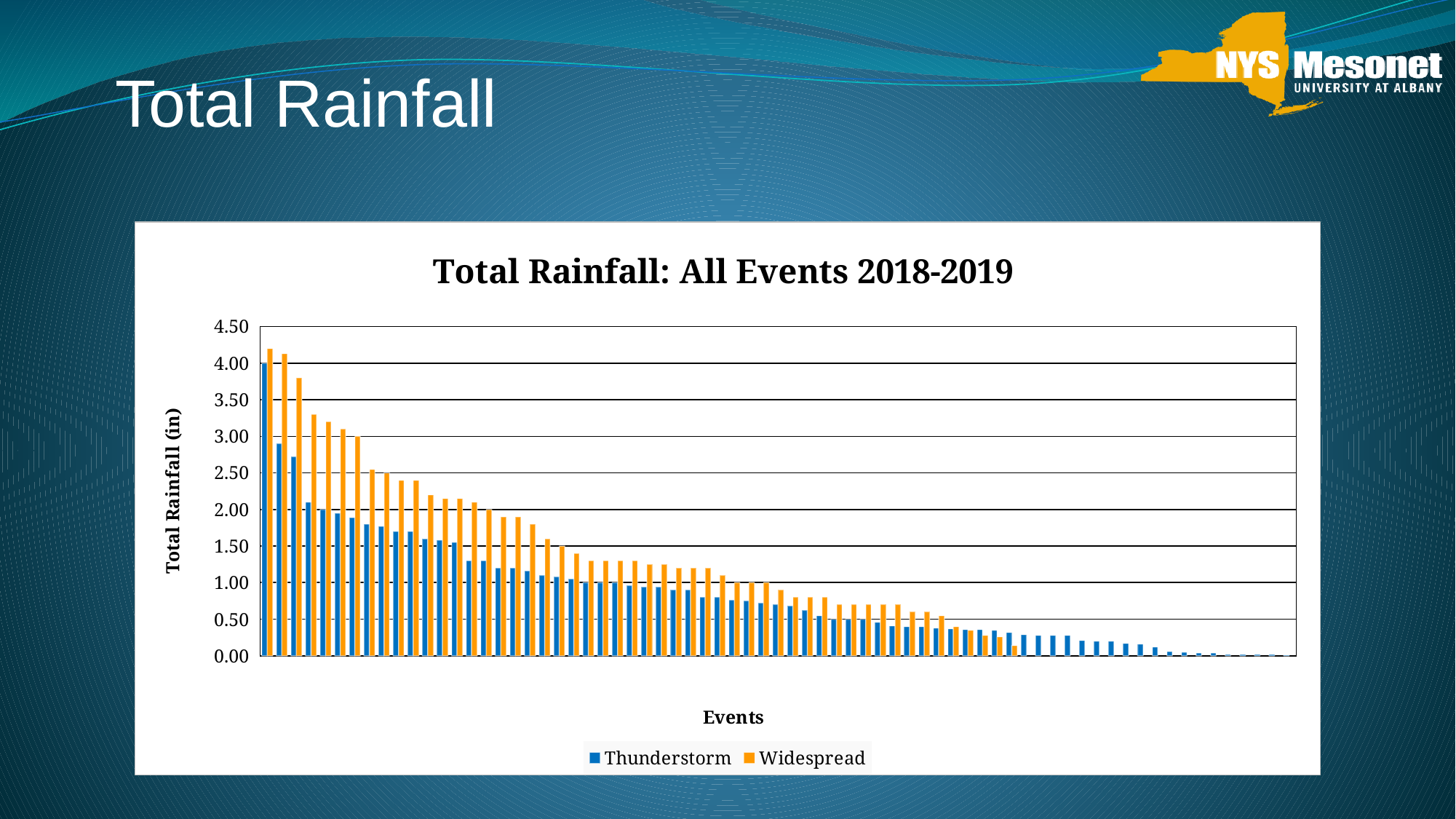
Is the second Thunderstorm bar from the left greater or less than 3.00? less Is the third Widespread bar from the left greater or less than 3.50? greater What is the title of the chart? Total Rainfall: All Events 2018-2019 Is the tallest Thunderstorm bar greater or less than 3.50? greater What is the label on the vertical axis of the chart? Total Rainfall (in) What kind of chart is shown on the slide? Bar chart What is the highest value shown on the vertical axis? 4.50 Do the bar values rise or fall from left to right along the x axis? Fall Which series contains the tallest bar in the chart, Thunderstorm or Widespread? Widespread How many series does the legend list? 2